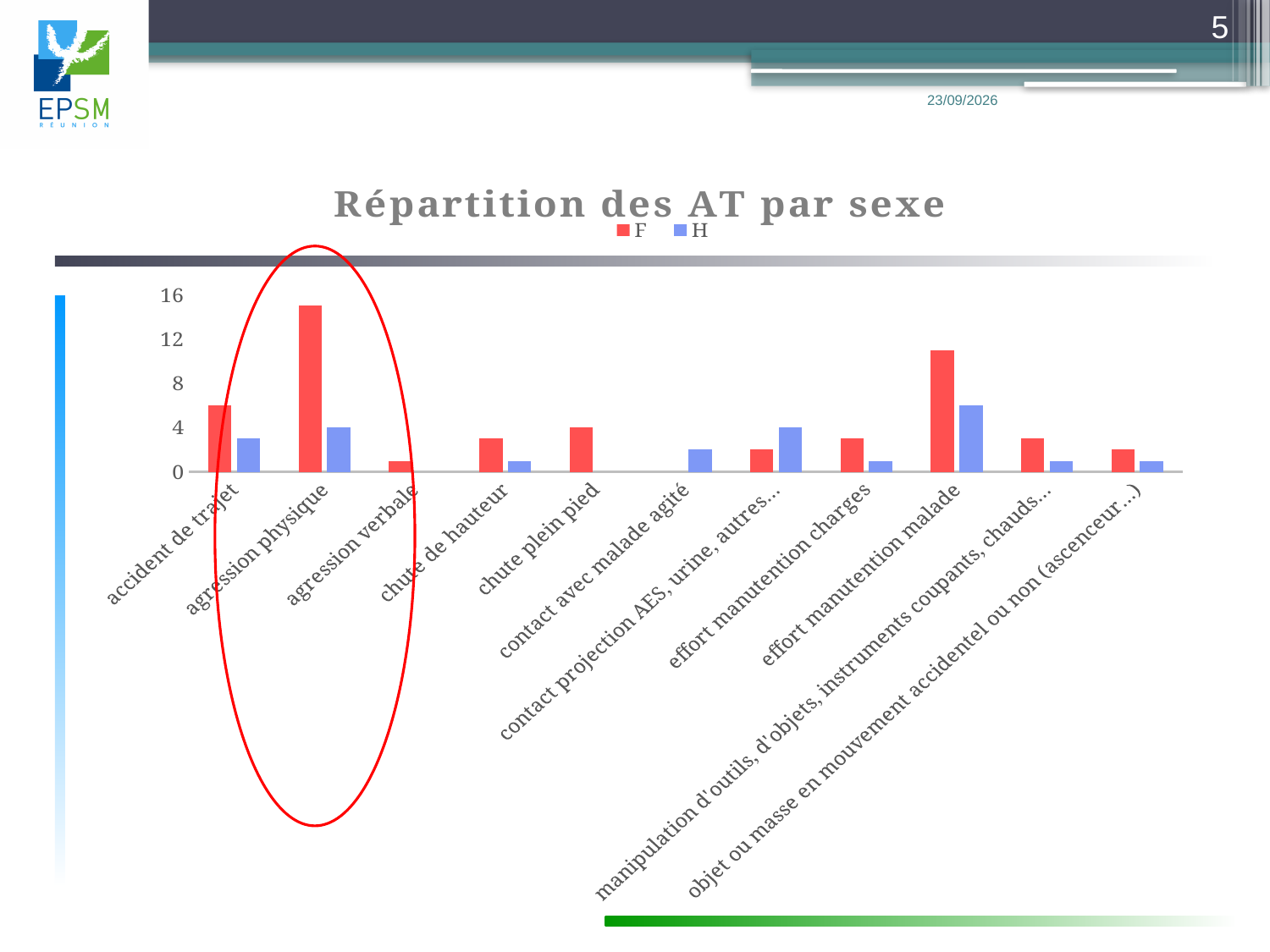
For agression physique, which series has the larger value, F or H? F For contact projection AES, urine, autres..., which series has the larger value, F or H? H Which category has the highest value for the F series? agression physique What kind of chart is shown on the slide? bar chart Is the F value for agression verbale greater or less than 4? less What is the title of the chart? Répartition des AT par sexe Is the F value for effort manutention malade greater or less than 8? greater Which category has the highest value for the H series? effort manutention malade How many categories are shown on the x axis? 11 Is the F value for agression physique greater or less than 12? greater How many series does the legend list? 2 What are the two series named in the legend? F and H